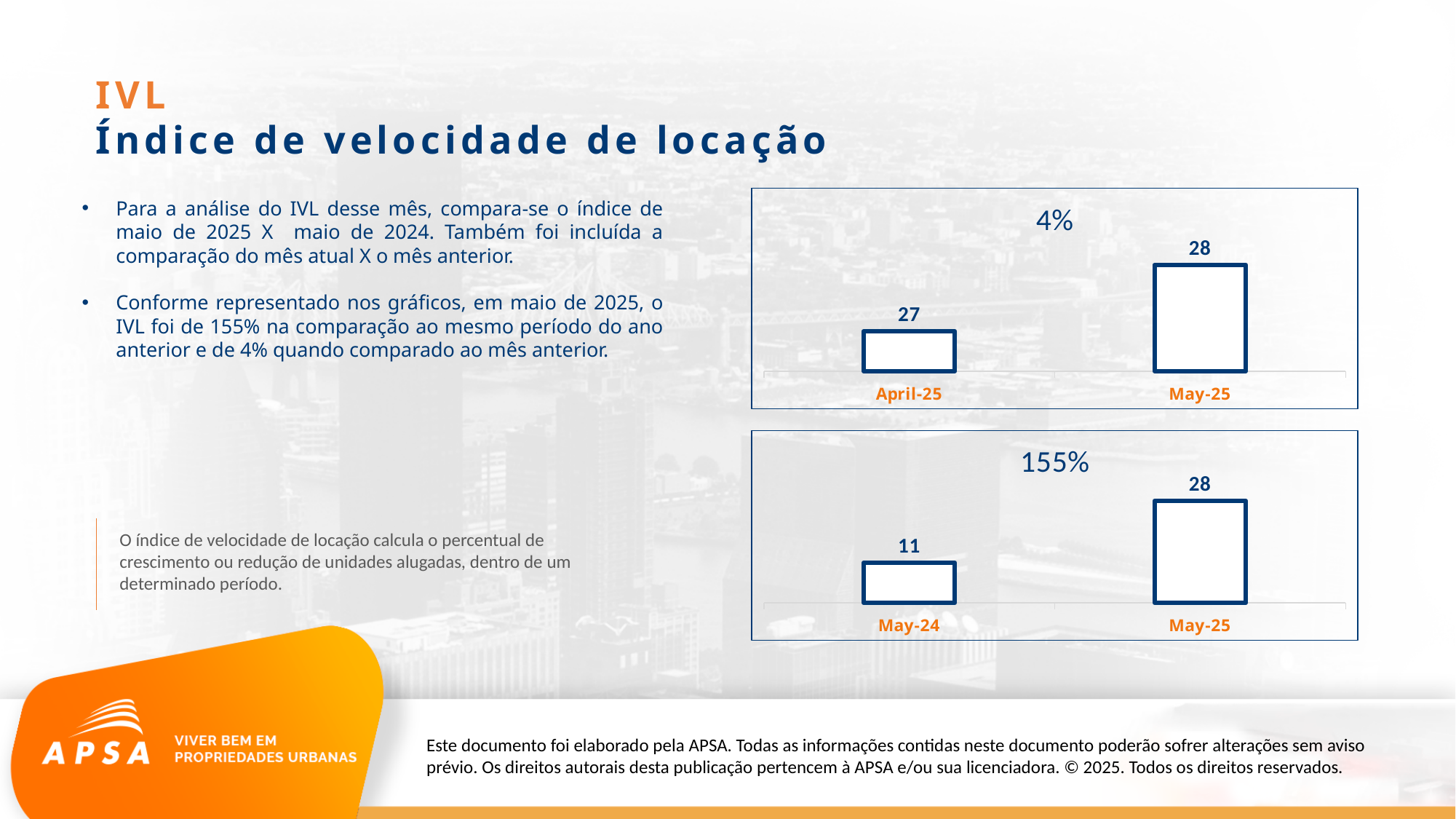
How many categories are shown in the top chart? 2 In the top chart, what is the value for April-25? 27 In the top chart, what is the difference between the May-25 and April-25 values? 1 In the bottom chart, which category has the highest value? May-25 In the bottom chart, which is larger, the value for May-24 or May-25? May-25 In the bottom chart, what is the difference between the May-25 and May-24 values? 17 In the bottom chart, which category has the lowest value? May-24 In the bottom chart, what is the value for May-24? 11 What kind of chart is the bottom chart? Bar chart In the top chart, what is the value for May-25? 28 In the bottom chart, what is the value for May-25? 28 What percentage is printed above the bars in the bottom chart? 155%